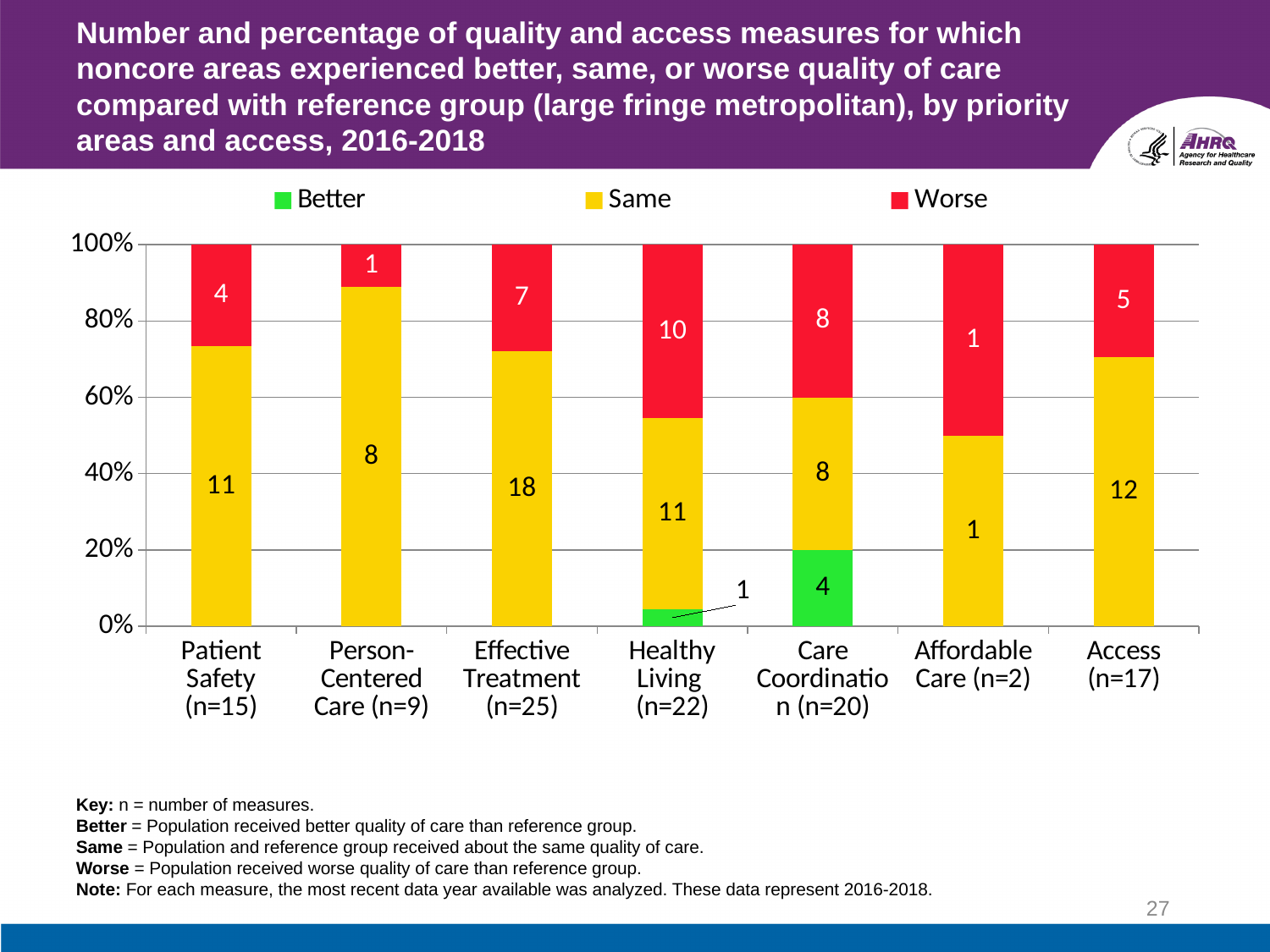
Which priority area has the highest number of Worse measures? Healthy Living Which colour represents the Worse series in the legend? Red How many series does the legend list? 3 What is the total number of measures in the Care Coordination bar (Better + Same + Worse)? 20 How many measures were rated Worse for Healthy Living? 10 Which category has the highest number of Same measures? Effective Treatment How many measures were rated Better for Care Coordination? 4 What kind of chart is shown on the slide? Stacked bar chart How many measures were rated Same for Effective Treatment? 18 Which is larger for Access: the number of Same measures or the number of Worse measures? Same How many categories are shown on the x axis? 7 What is the difference between the Same and Worse counts for Patient Safety? 7